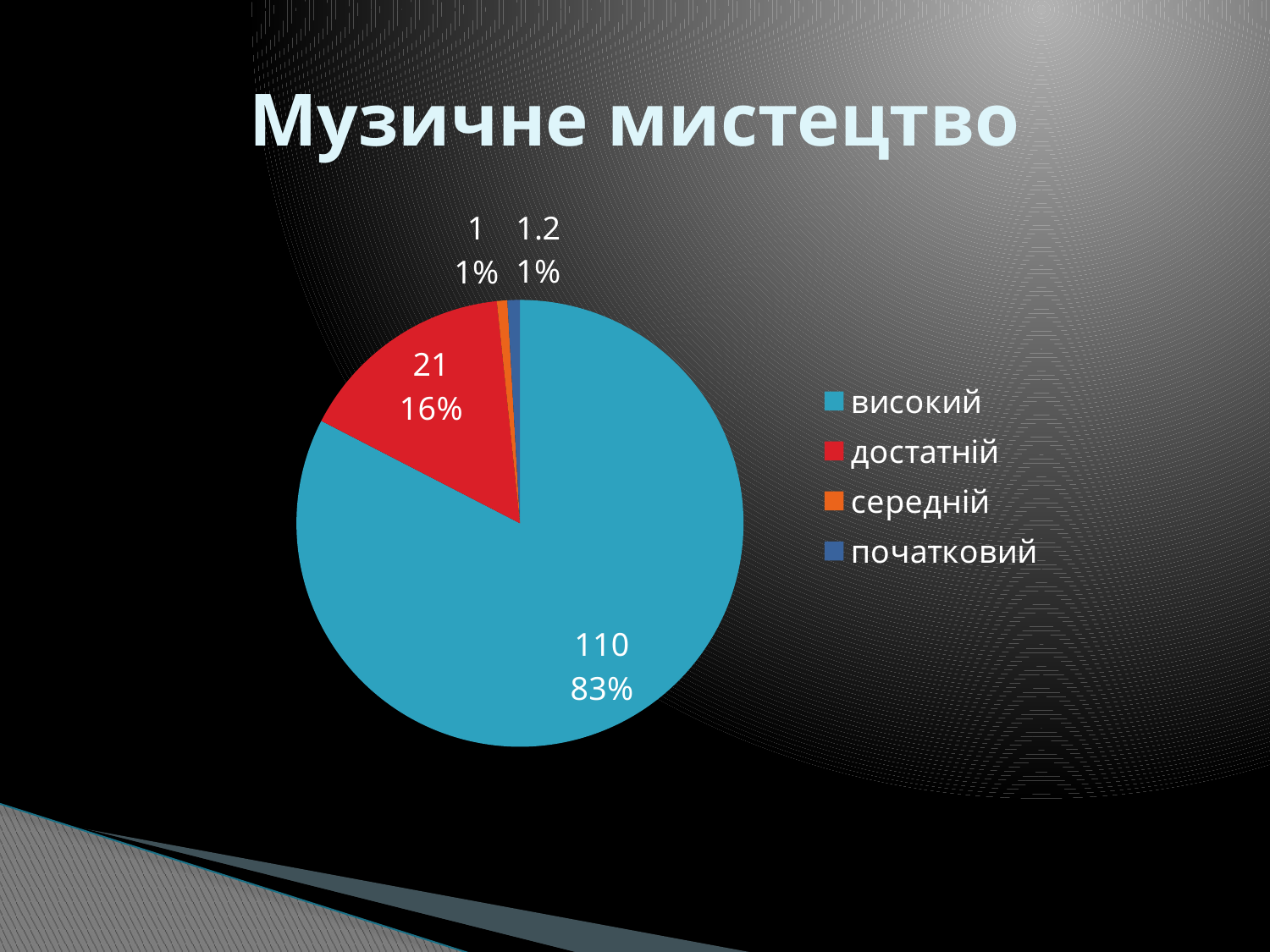
Which is larger, the 'високий' slice or the 'достатній' slice? високий How many slices does the pie chart have? 4 What share of the pie does the 'високий' slice represent? 83% What share of the pie does the 'достатній' slice represent? 16% What kind of chart is shown on the slide? pie chart What is the value shown for the 'достатній' slice? 21 Which category has the largest slice of the pie? високий What is the title of the chart? Музичне мистецтво What colour is the 'достатній' slice? red What is the difference between the values for 'високий' and 'достатній'? 89 What is the value shown for the 'високий' slice? 110 How many entries does the legend list? 4